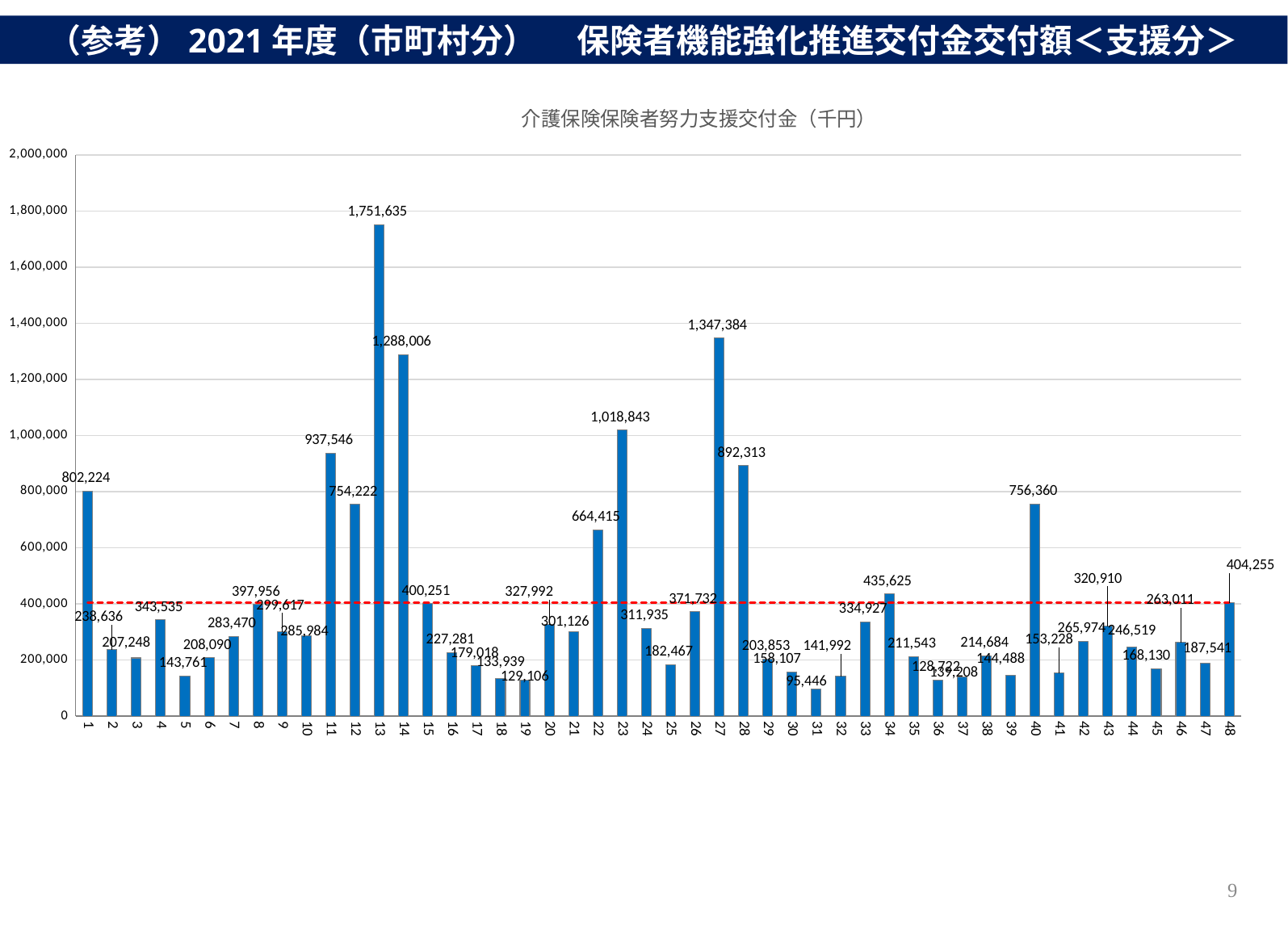
What is the value for category 27? 1,347,384 Which category has the lowest value? 31 At what value on the y axis is the red dashed horizontal line drawn? 404,255 What is the value for category 31? 95,446 What is the value for category 48? 404,255 How many categories are shown on the x axis? 48 Which category has the highest value? 13 What is the value for category 13? 1,751,635 What is the difference between the values for category 27 and category 23? 328,541 What kind of chart is this? bar chart Which is larger, the value for category 11 or the value for category 28? 11 What is the difference between the values for category 13 and category 14? 463,629